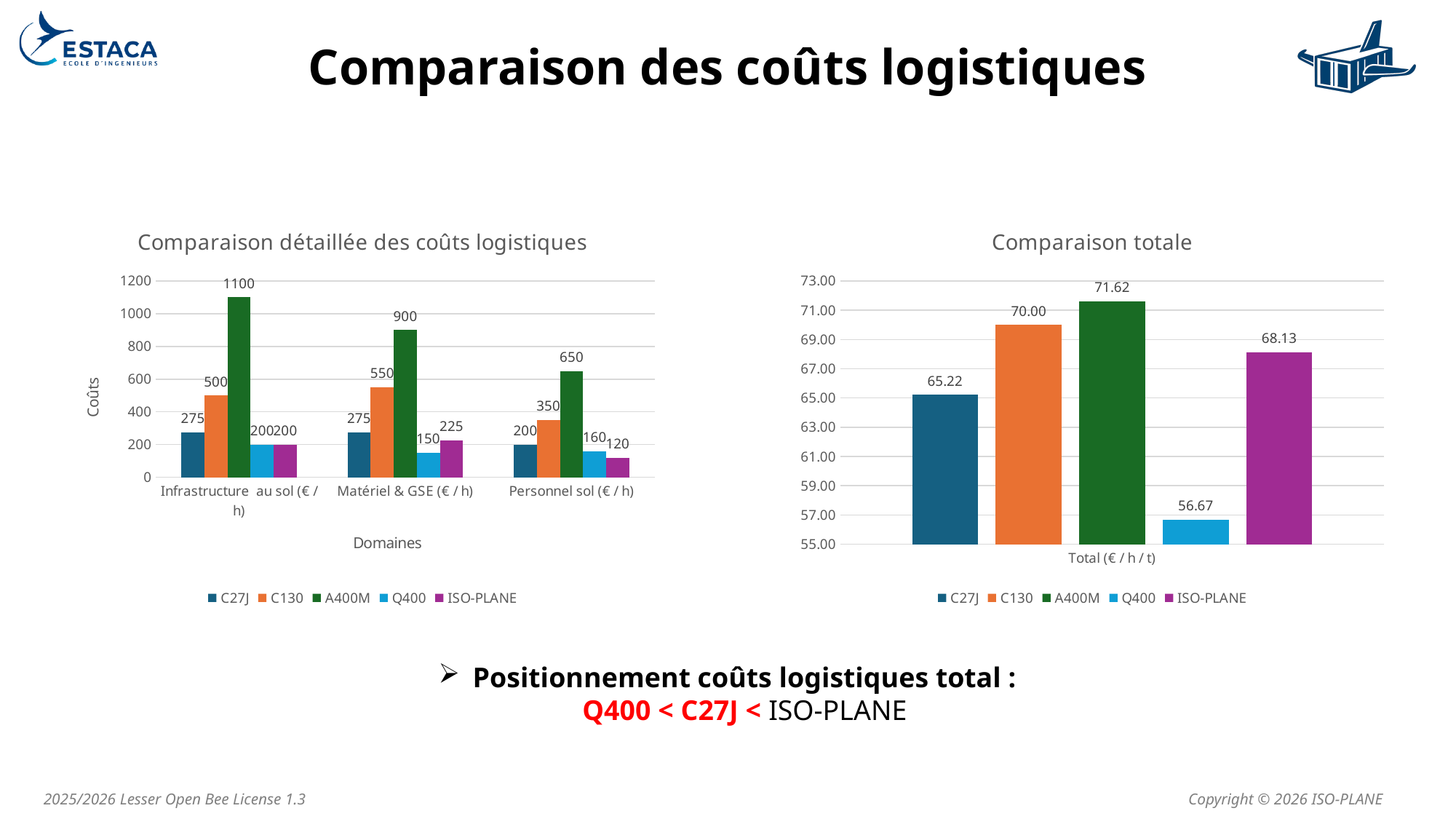
In the 'Comparaison détaillée des coûts logistiques' chart, which series has the lowest value in the Personnel sol (€ / h) category? ISO-PLANE In the 'Comparaison détaillée des coûts logistiques' chart, what is the label of the y axis? Coûts In the 'Comparaison totale' chart, which is larger, the value for C130 or the value for ISO-PLANE? C130 In the 'Comparaison détaillée des coûts logistiques' chart, what is the difference between the C130 and C27J values in the Matériel & GSE (€ / h) category? 275 In the 'Comparaison totale' chart, what is the value for Q400? 56.67 In the 'Comparaison totale' chart, which series has the highest value? A400M How many series does the legend of the 'Comparaison totale' chart list? 5 In the 'Comparaison détaillée des coûts logistiques' chart, how many categories are shown on the x axis? 3 In the 'Comparaison détaillée des coûts logistiques' chart, what is the value for ISO-PLANE in the Matériel & GSE (€ / h) category? 225 In the 'Comparaison totale' chart, what is the difference between the A400M and C27J values? 6.40 What kind of chart is the 'Comparaison totale' chart? Bar chart In the 'Comparaison détaillée des coûts logistiques' chart, what is the value for A400M in the Infrastructure au sol (€ / h) category? 1100